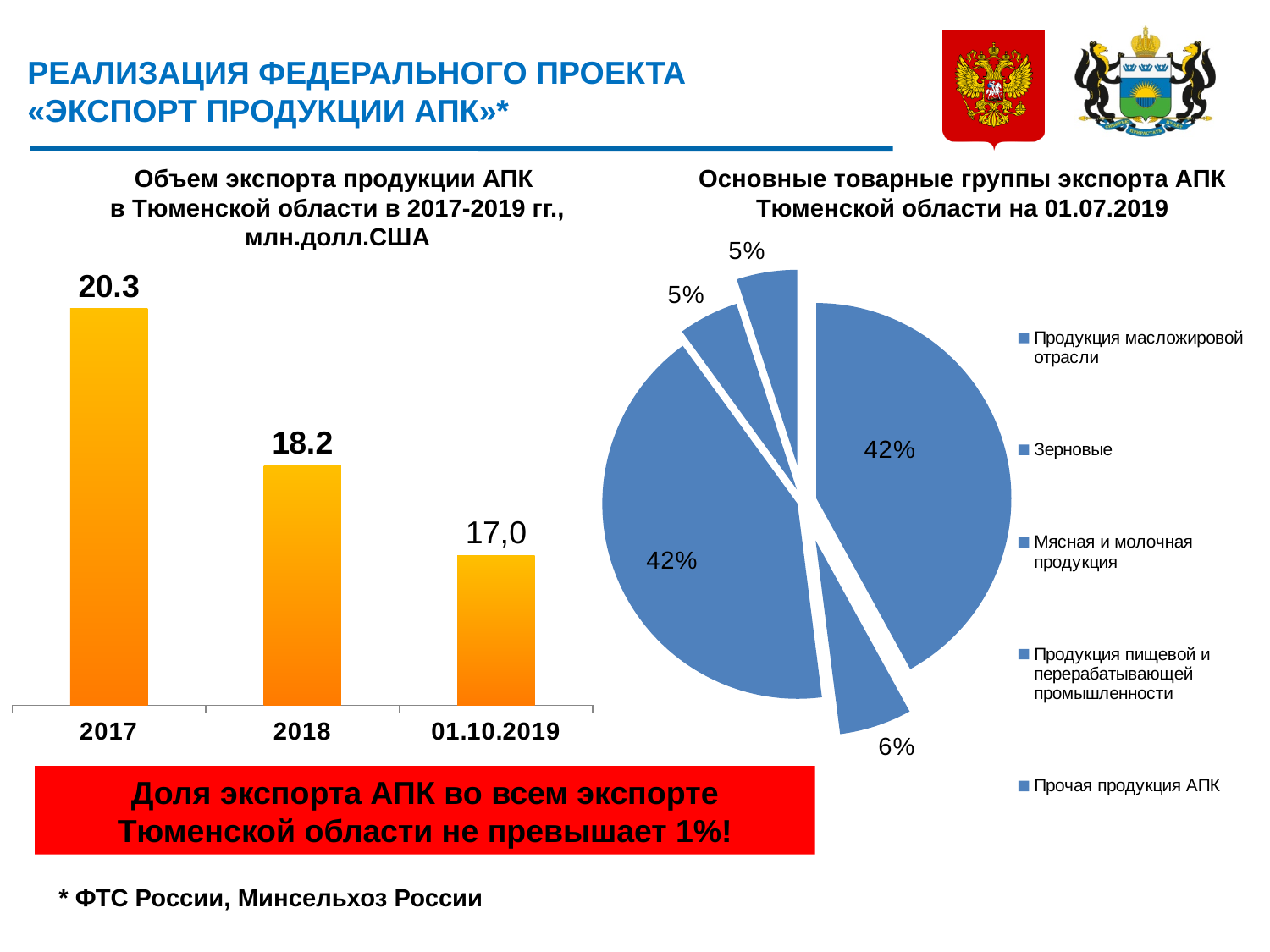
In the bar chart on the left, by how much did the export volume fall from 2017 to 2018? 2.1 How many entries does the legend of the pie chart on the right list? 5 In the bar chart on the left, is the value for 2018 larger or smaller than the value for 2017? smaller In the bar chart on the left, do the values rise or fall from 2017 to 01.10.2019? fall In the pie chart on the right, what is the largest percentage shown on any slice? 42% How many bars are shown in the bar chart on the left? 3 In the bar chart on the left, which period has the highest export volume? 2017 In the bar chart on the left, which period has the lowest export volume? 01.10.2019 In the bar chart on the left, what value is shown for 01.10.2019? 17,0 In the bar chart on the left, what value is shown for 2018? 18.2 What kind of chart is the chart on the right of the slide? pie chart In the bar chart on the left, what was the export volume of agricultural products in 2017? 20.3